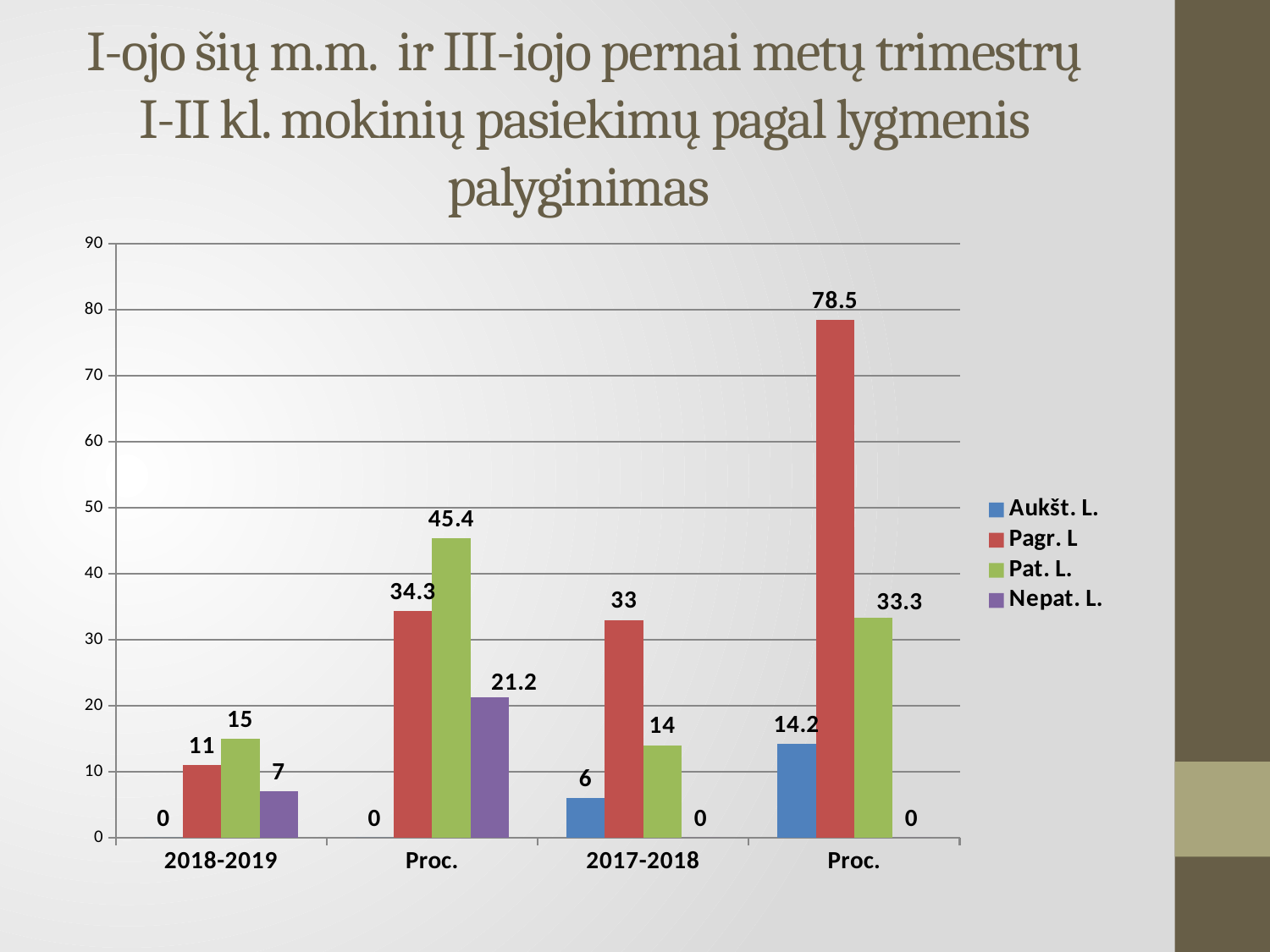
Which is larger in the 2017-2018 category: Pagr. L or Pat. L.? Pagr. L What type of chart is shown on the slide? bar chart What is the value of Pat. L. in the Proc. category that follows 2018-2019? 45.4 Which series is shown in green in the legend? Pat. L. What is the difference between Pagr. L and Pat. L. in the Proc. category that follows 2017-2018? 45.2 What is the value of Nepat. L. in the Proc. category that follows 2018-2019? 21.2 Which series has the highest value in the Proc. category that follows 2017-2018? Pagr. L What is the value of Pagr. L for the 2018-2019 category? 11 How many categories are shown on the x axis? 4 What is the value of Aukšt. L. for the 2017-2018 category? 6 Which series has the lowest value in the 2018-2019 category? Aukšt. L. How many series does the legend list? 4